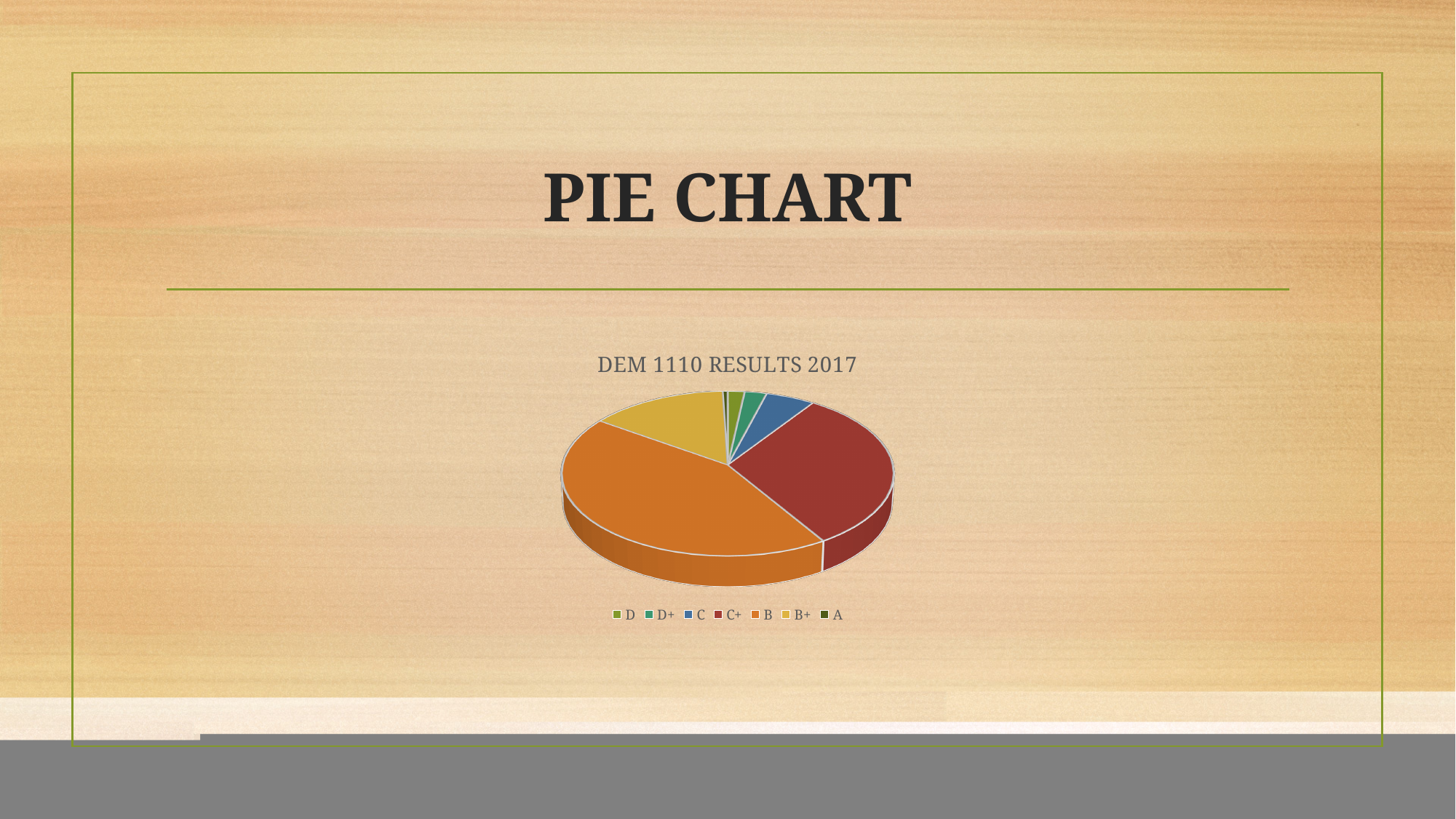
Which slice is larger, C+ or B+? C+ Which grade has the smallest slice of the pie? A What is the title of the chart? DEM 1110 RESULTS 2017 How many categories does the pie chart have? 7 What colour is the slice for B? orange What kind of chart is shown on the slide? pie chart How many entries does the legend list? 7 Which grade has the largest slice of the pie? B Which slice is larger, C or D+? C Which slice is larger, B or C+? B